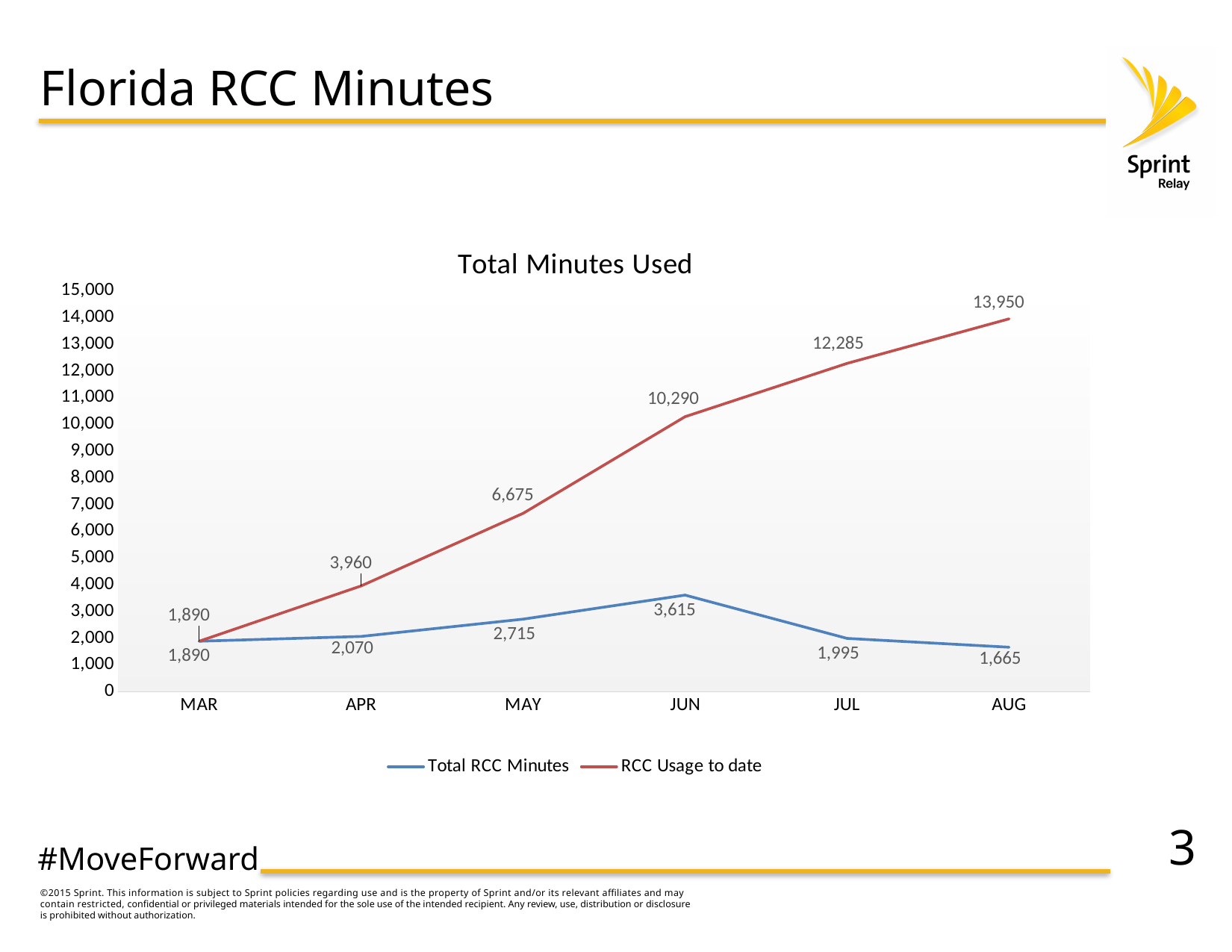
What is the difference between RCC Usage to date in AUG and in JUL? 1,665 What is the value of RCC Usage to date for AUG? 13,950 Which is larger, Total RCC Minutes in JUL or in AUG? JUL Which month has the highest Total RCC Minutes? JUN What is the value of Total RCC Minutes for JUN? 3,615 What is the value of Total RCC Minutes for APR? 2,070 What kind of chart is shown on the slide? Line chart How many series does the legend list? 2 Which month has the lowest Total RCC Minutes? AUG How many months are shown on the x axis? 6 Does RCC Usage to date rise or fall from MAR to AUG? Rise What is the difference between Total RCC Minutes in JUN and in MAY? 900